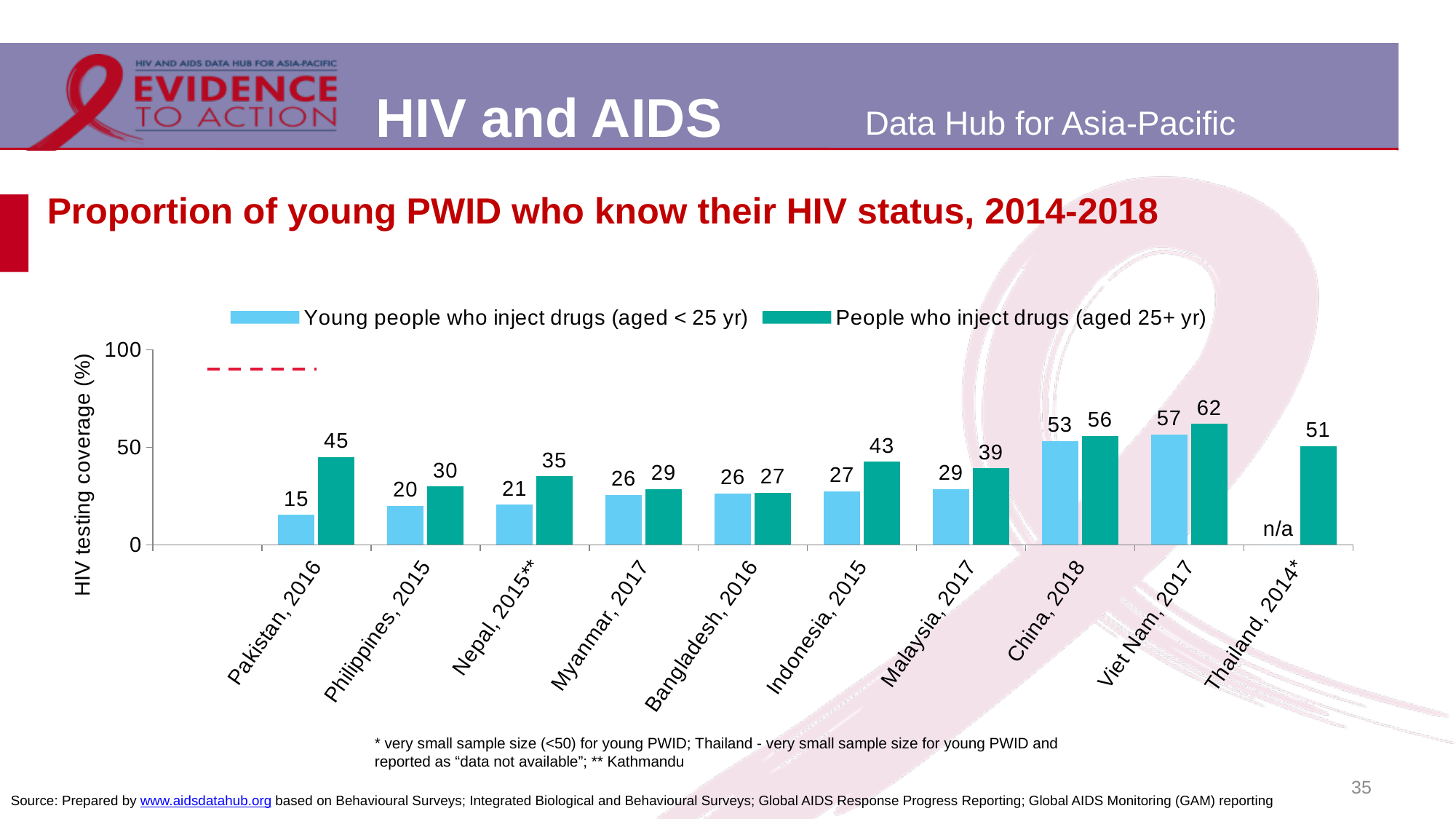
Which is larger for Indonesia, 2015: the value for young people who inject drugs (aged < 25 yr) or the value for people who inject drugs (aged 25+ yr)? People who inject drugs (aged 25+ yr) Is the value for people who inject drugs (aged 25+ yr) in China, 2018 greater or less than 50? greater Which country has the highest value for young people who inject drugs (aged < 25 yr)? Viet Nam, 2017 What is the label shown for young people who inject drugs (aged < 25 yr) in Thailand, 2014*? n/a What kind of chart is shown on the slide? Bar chart Which country has the lowest value for young people who inject drugs (aged < 25 yr)? Pakistan, 2016 What is the value for people who inject drugs (aged 25+ yr) in Viet Nam, 2017? 62 What is the difference between the aged 25+ yr value and the aged < 25 yr value for Pakistan, 2016? 30 What is the value for people who inject drugs (aged 25+ yr) in Thailand, 2014*? 51 How many series does the legend list? 2 What is the value for young people who inject drugs (aged < 25 yr) in Pakistan, 2016? 15 How many country categories are shown on the x axis? 10